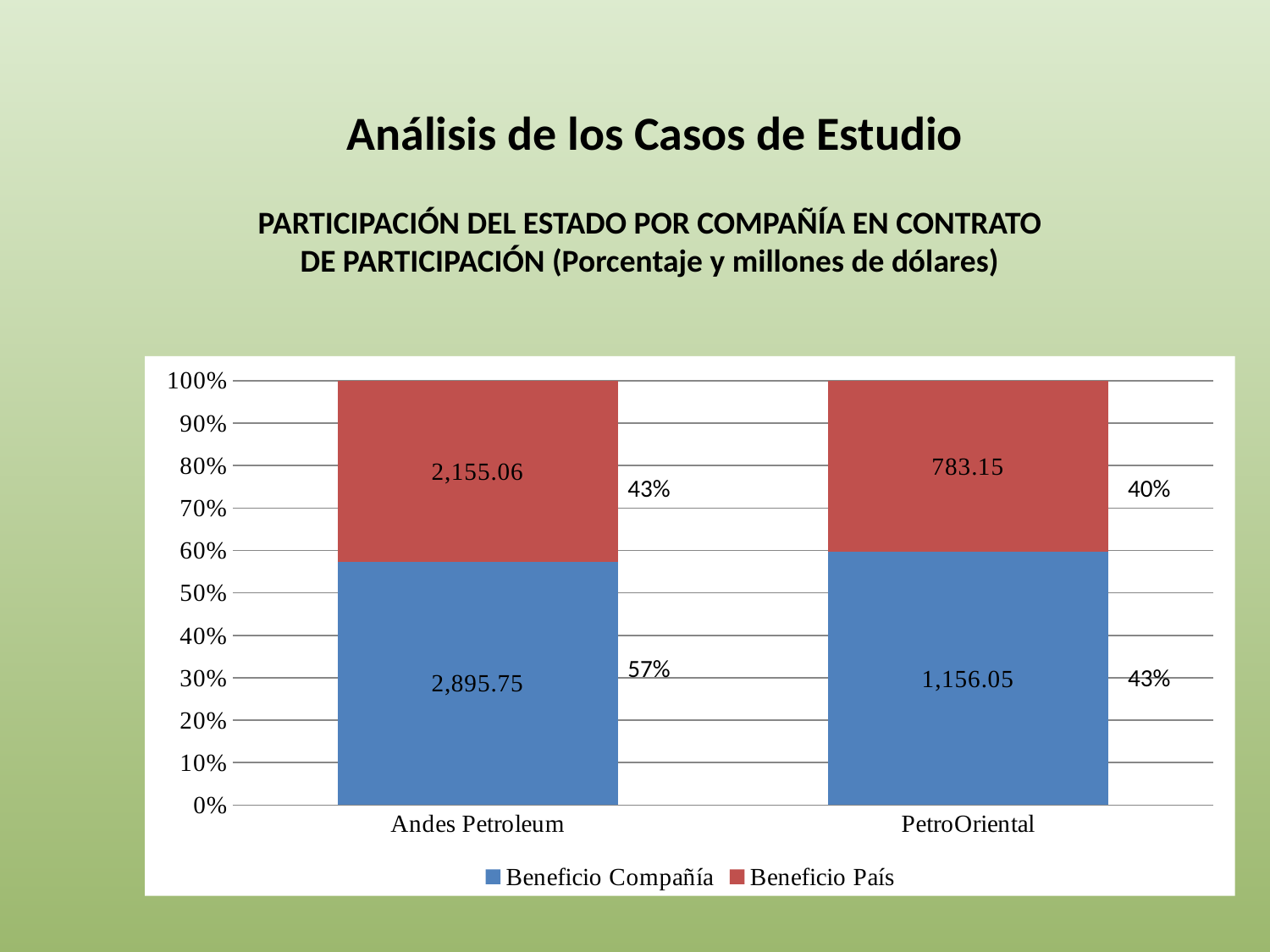
Is the Beneficio Compañía value for PetroOriental larger or smaller than its Beneficio País value? larger How many companies are shown on the x axis? 2 Which company has the higher Beneficio País value? Andes Petroleum What is the Beneficio Compañía value for Andes Petroleum? 2,895.75 What is the difference between the Beneficio Compañía and Beneficio País values for Andes Petroleum? 740.69 How many series does the legend list? 2 What is the Beneficio Compañía value for PetroOriental? 1,156.05 What is the Beneficio País value for Andes Petroleum? 2,155.06 What kind of chart is shown on the slide? Stacked bar chart Is the Beneficio Compañía share of the Andes Petroleum bar greater or less than 50%? greater What is the Beneficio País value for PetroOriental? 783.15 Which company has the lower Beneficio Compañía value? PetroOriental